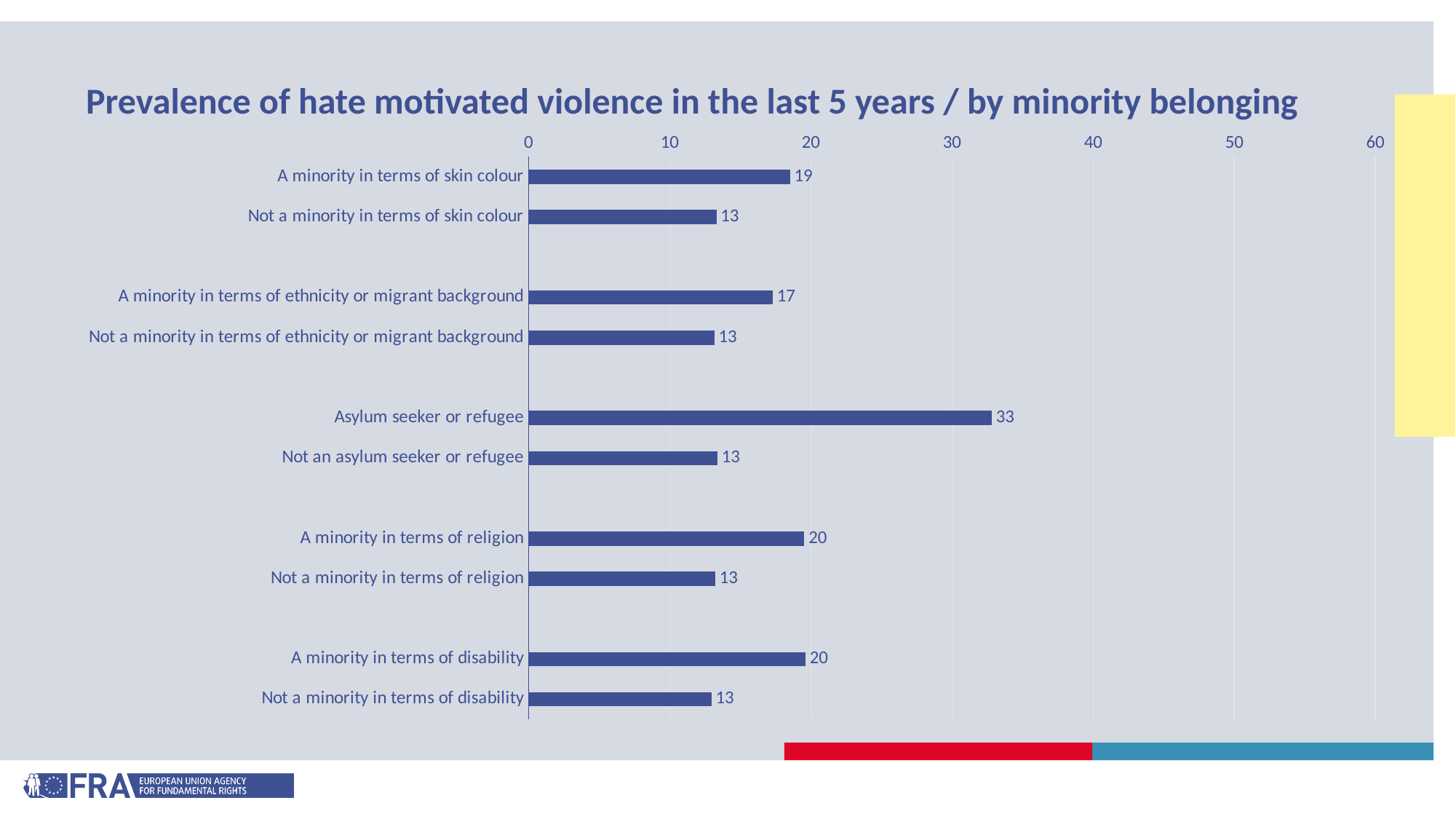
How many categories are shown in the chart? 10 Which category has the highest value? Asylum seeker or refugee Is the value for 'Asylum seeker or refugee' greater or less than 30? greater What kind of chart is shown on the slide? Bar chart What is the value for 'A minority in terms of ethnicity or migrant background'? 17 What is the difference between 'A minority in terms of skin colour' and 'Not a minority in terms of skin colour'? 6 Which is larger: 'A minority in terms of religion' or 'A minority in terms of ethnicity or migrant background'? A minority in terms of religion What is the value for 'A minority in terms of skin colour'? 19 What is the value for 'Asylum seeker or refugee'? 33 What is the value for 'Not a minority in terms of religion'? 13 What is the title of the chart? Prevalence of hate motivated violence in the last 5 years / by minority belonging What is the difference between 'Asylum seeker or refugee' and 'Not an asylum seeker or refugee'? 20